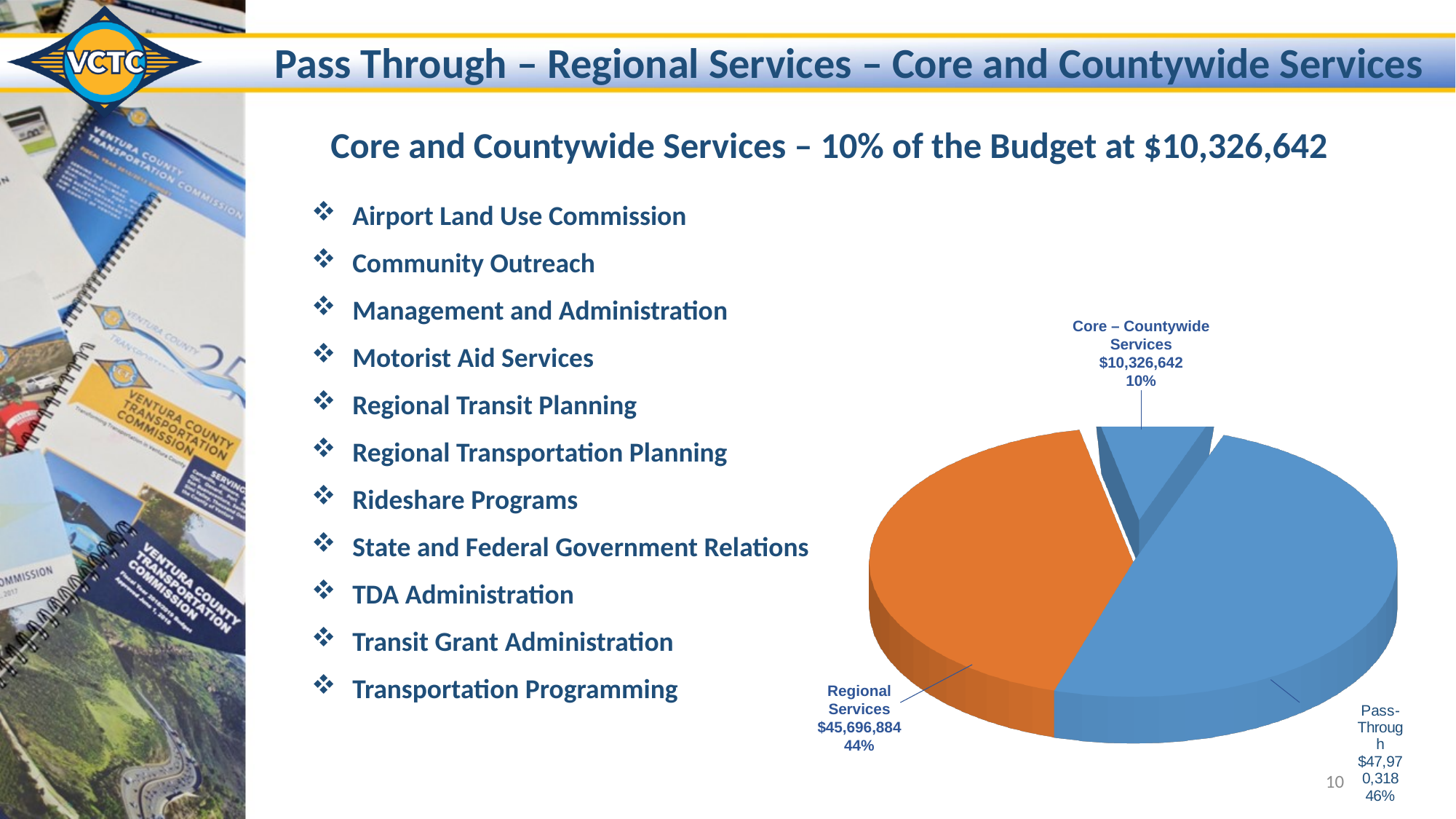
What is the dollar value of the Regional Services slice? $45,696,884 What share of the pie does Regional Services represent? 44% What colour is the Regional Services slice? Orange What kind of chart is shown on the slide? Pie chart How many slices does the pie chart have? 3 What share of the pie does Pass-Through represent? 46% What is the difference in dollars between Pass-Through and Regional Services? $2,273,434 Which is larger, Pass-Through or Regional Services? Pass-Through Which slice of the pie chart is the largest? Pass-Through What is the dollar value of the Pass-Through slice? $47,970,318 Which slice of the pie chart is the smallest? Core – Countywide Services What is the dollar value of the Core – Countywide Services slice? $10,326,642